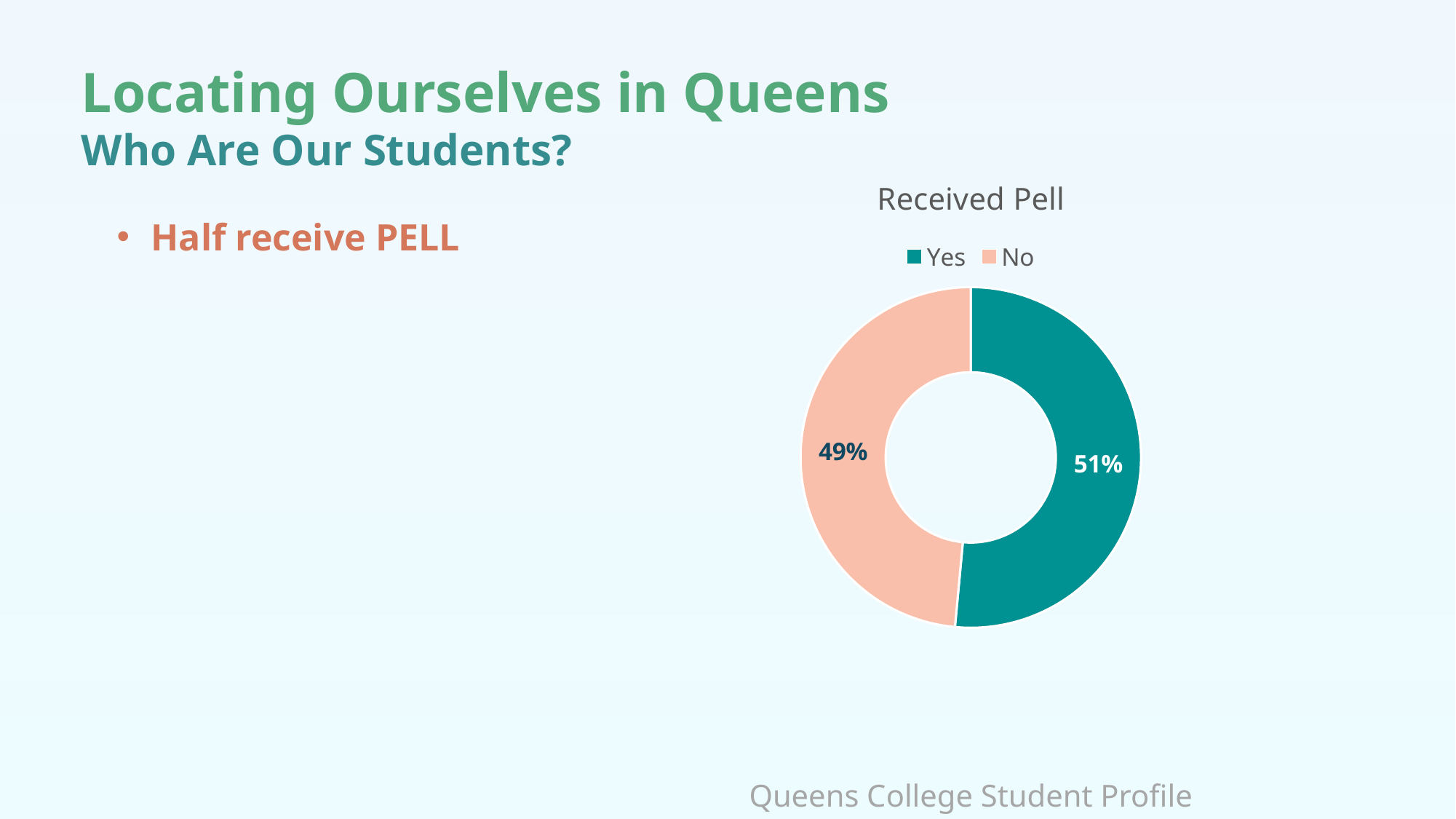
What is the difference in percentage points between the Yes and No slices? 2% How many entries does the legend of the Received Pell chart list? 2 What share of the pie does the No slice represent? 49% Which category has the smaller share in the Received Pell chart? No What kind of chart is shown on the slide? Pie chart (doughnut) Which colour represents the Yes category in the chart? Teal What percentage of students received Pell according to the chart? 51% How many categories are shown in the Received Pell chart? 2 What percentage of students did not receive Pell according to the chart? 49% What is the title of the chart on the slide? Received Pell Which category has the larger share in the Received Pell chart? Yes Is the share for Yes larger or smaller than the share for No? larger